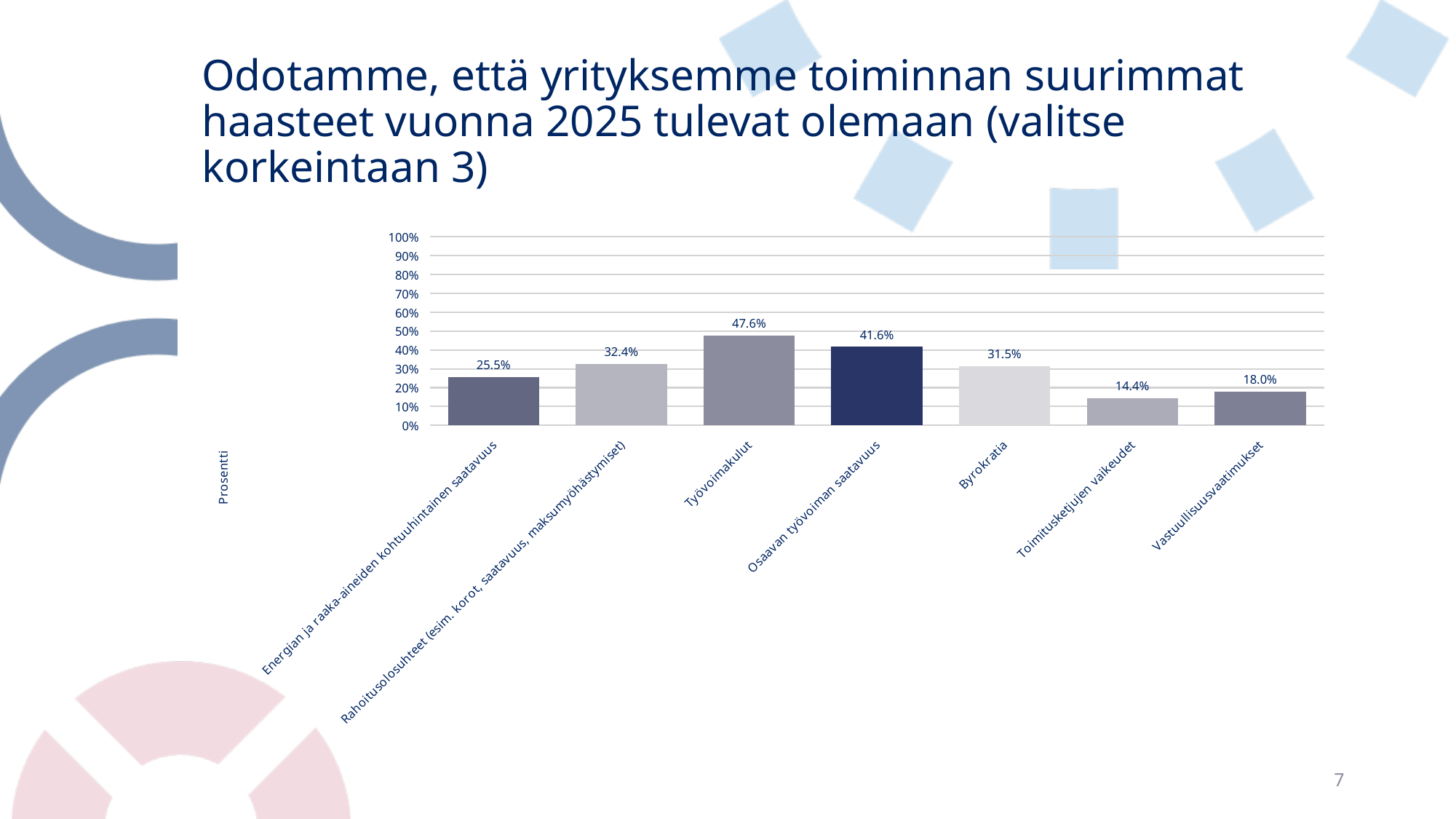
What is the difference between the values for Työvoimakulut and Osaavan työvoiman saatavuus? 6.0% What is the value for Byrokratia? 31.5% Which category has the lowest value? Toimitusketjujen vaikeudet How many categories are shown in the chart? 7 Which category has the highest value? Työvoimakulut What is the label on the vertical axis of the chart? Prosentti Is the value for Osaavan työvoiman saatavuus greater or less than 50%? less What is the value for Toimitusketjujen vaikeudet? 14.4% What is the value for Vastuullisuusvaatimukset? 18.0% Which is larger, the value for Energian ja raaka-aineiden kohtuuhintainen saatavuus or the value for Byrokratia? Byrokratia What kind of chart is shown on the slide? bar chart What is the value for Työvoimakulut? 47.6%